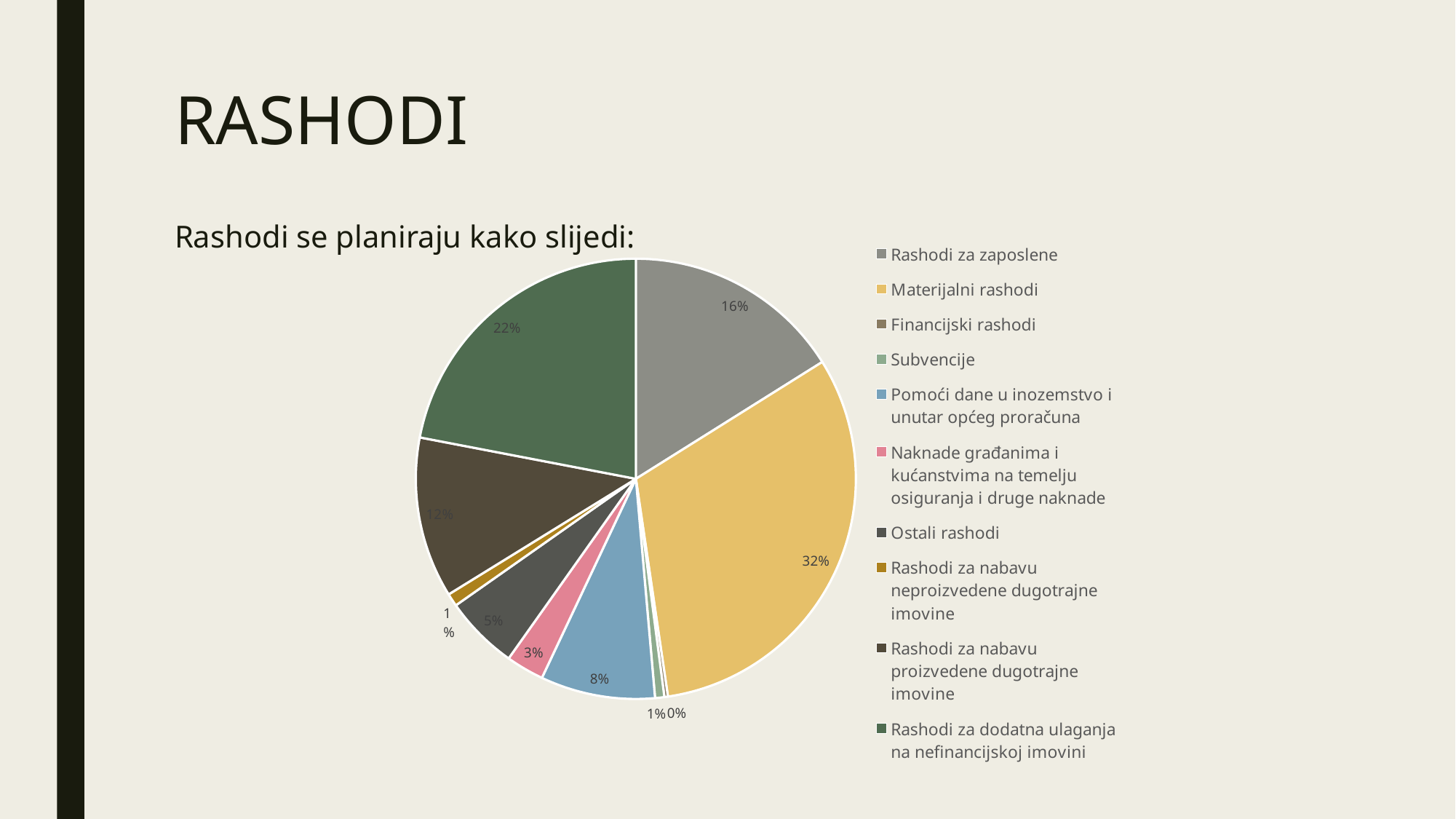
What is the title of the slide? RASHODI What percentage is shown for Naknade građanima i kućanstvima na temelju osiguranja i druge naknade? 3% What kind of chart is shown on the slide? pie chart What share of the pie does Materijalni rashodi have? 32% Which is larger: Rashodi za zaposlene or Rashodi za dodatna ulaganja na nefinancijskoj imovini? Rashodi za dodatna ulaganja na nefinancijskoj imovini What percentage is shown for Rashodi za dodatna ulaganja na nefinancijskoj imovini? 22% What percentage is shown for Pomoći dane u inozemstvo i unutar općeg proračuna? 8% What percentage is shown for Rashodi za zaposlene? 16% Which is larger: Pomoći dane u inozemstvo i unutar općeg proračuna or Naknade građanima i kućanstvima na temelju osiguranja i druge naknade? Pomoći dane u inozemstvo i unutar općeg proračuna What is the difference in percentage points between Materijalni rashodi and Rashodi za zaposlene? 16 percentage points How many categories does the legend list? 10 Which category has the largest slice of the pie? Materijalni rashodi